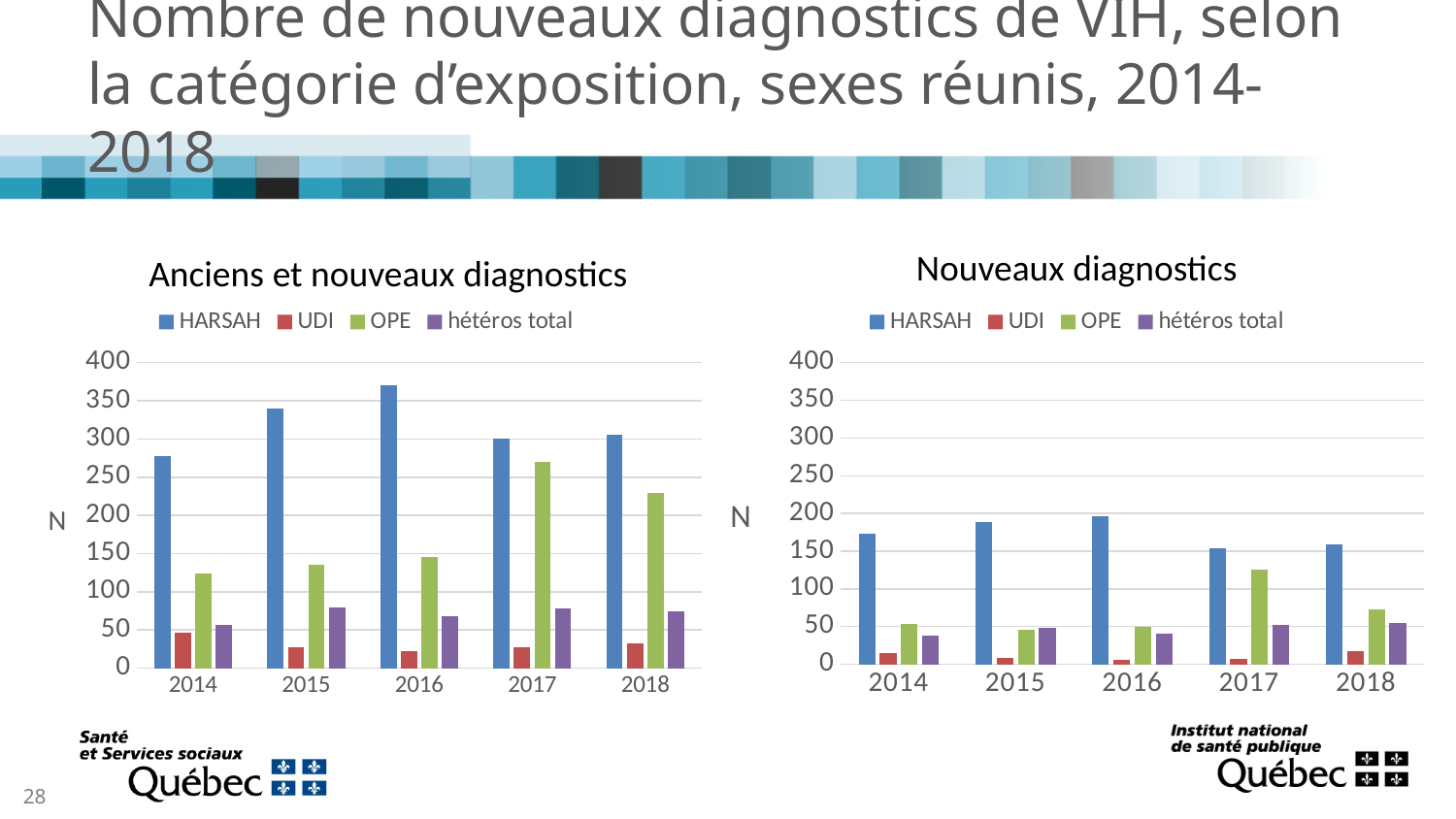
How many years are shown on the x axis of the 'Anciens et nouveaux diagnostics' chart? 5 In the 'Anciens et nouveaux diagnostics' chart, which is larger in 2018: OPE or hétéros total? OPE In the 'Nouveaux diagnostics' chart, does the HARSAH value rise or fall from 2016 to 2017? fall In the 'Nouveaux diagnostics' chart, is the HARSAH value for 2014 greater or less than 150? greater In the 'Anciens et nouveaux diagnostics' chart, which year has the highest HARSAH bar? 2016 What kind of chart is the 'Anciens et nouveaux diagnostics' chart on the left? Bar chart In the 'Anciens et nouveaux diagnostics' chart, is the HARSAH value for 2016 greater or less than 350? greater In the 'Nouveaux diagnostics' chart, which year has the highest OPE bar? 2017 How many series does the legend of the 'Nouveaux diagnostics' chart list? 4 In the 'Nouveaux diagnostics' chart, which series has the lowest bar in 2018? UDI In the 'Anciens et nouveaux diagnostics' chart, is the OPE value for 2017 greater or less than 250? greater What colour represents the OPE series in the legends of both charts? Green